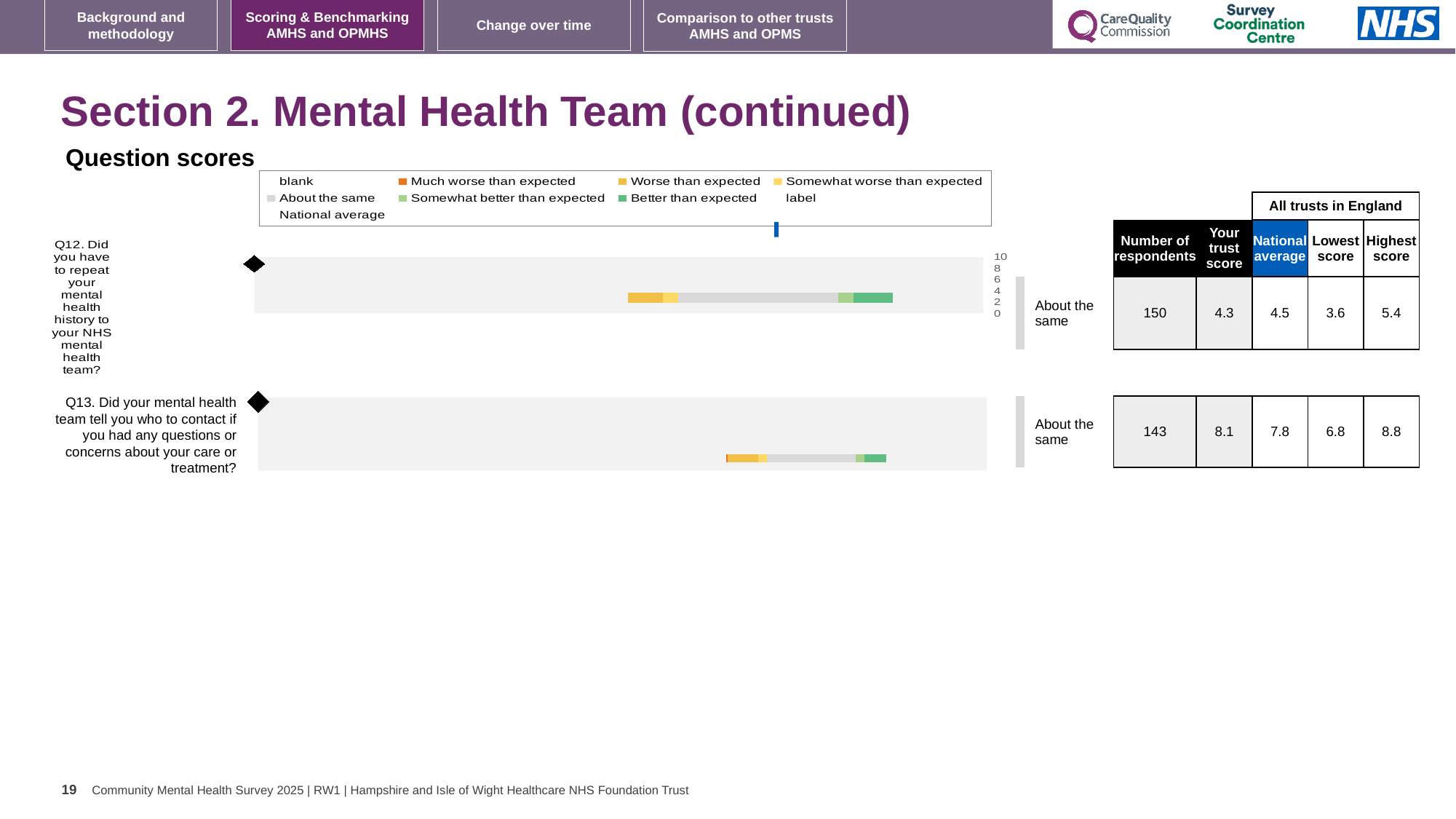
What is the highest value shown on the score axis of the Q12 chart? 10 How many respondents answered Q13? 143 What rating label is shown next to the Q13 chart? About the same What colour in the legend represents 'Better than expected'? green How many questions are plotted on the slide? 2 What is the trust score for Q12 in the table? 4.3 What is the national average for Q13 in the table? 7.8 What rating label is shown next to the Q12 chart? About the same What is the difference between the highest score and the lowest score for Q12? 1.8 Which is larger for Q13, the trust score or the national average? trust score Which question has the higher trust score, Q12 or Q13? Q13 What kind of chart is used to show the Q12 and Q13 question scores? bar chart